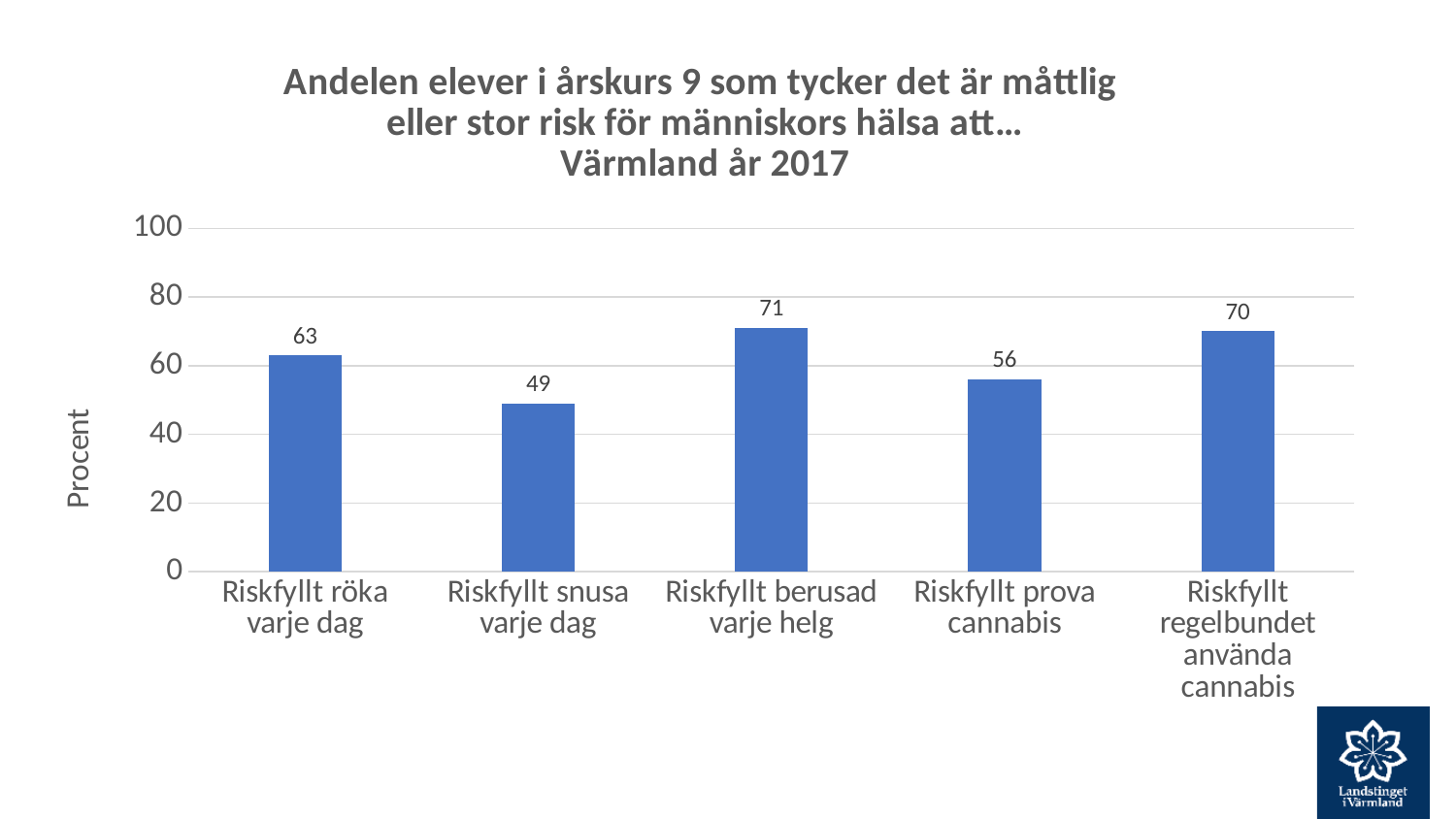
What is the difference between the values for "Riskfyllt berusad varje helg" and "Riskfyllt snusa varje dag"? 22 Is the value for "Riskfyllt snusa varje dag" greater or less than 60? less Which category has the highest value? Riskfyllt berusad varje helg What is the label on the vertical axis? Procent What is the value for "Riskfyllt röka varje dag"? 63 What is the value for "Riskfyllt snusa varje dag"? 49 What kind of chart is shown on the slide? Bar chart Which is larger, the value for "Riskfyllt regelbundet använda cannabis" or the value for "Riskfyllt röka varje dag"? Riskfyllt regelbundet använda cannabis Which category has the lowest value? Riskfyllt snusa varje dag How many categories are shown in the chart? 5 What is the difference between the values for "Riskfyllt röka varje dag" and "Riskfyllt prova cannabis"? 7 What is the value for "Riskfyllt prova cannabis"? 56